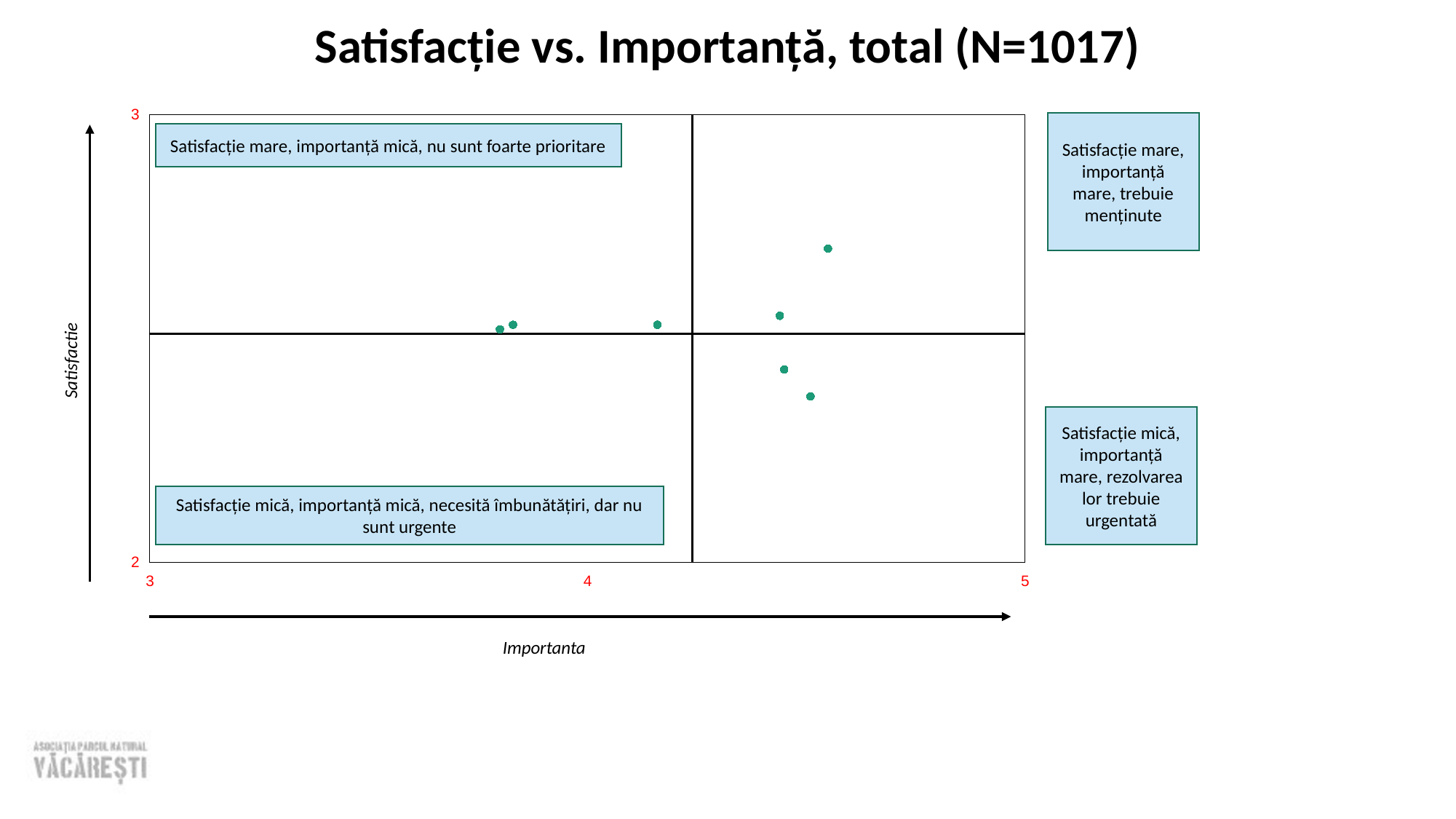
How many data points have an Importanta value greater than 4? 5 How many data points are plotted on the chart? 7 What is the title of the chart? Satisfacție vs. Importanță, total (N=1017) What kind of chart is shown on the slide? scatter chart How many data points have an Importanta value less than 4? 2 What label is on the horizontal axis of the chart? Importanta Are there more data points to the right of the vertical dividing line or to the left of it? right